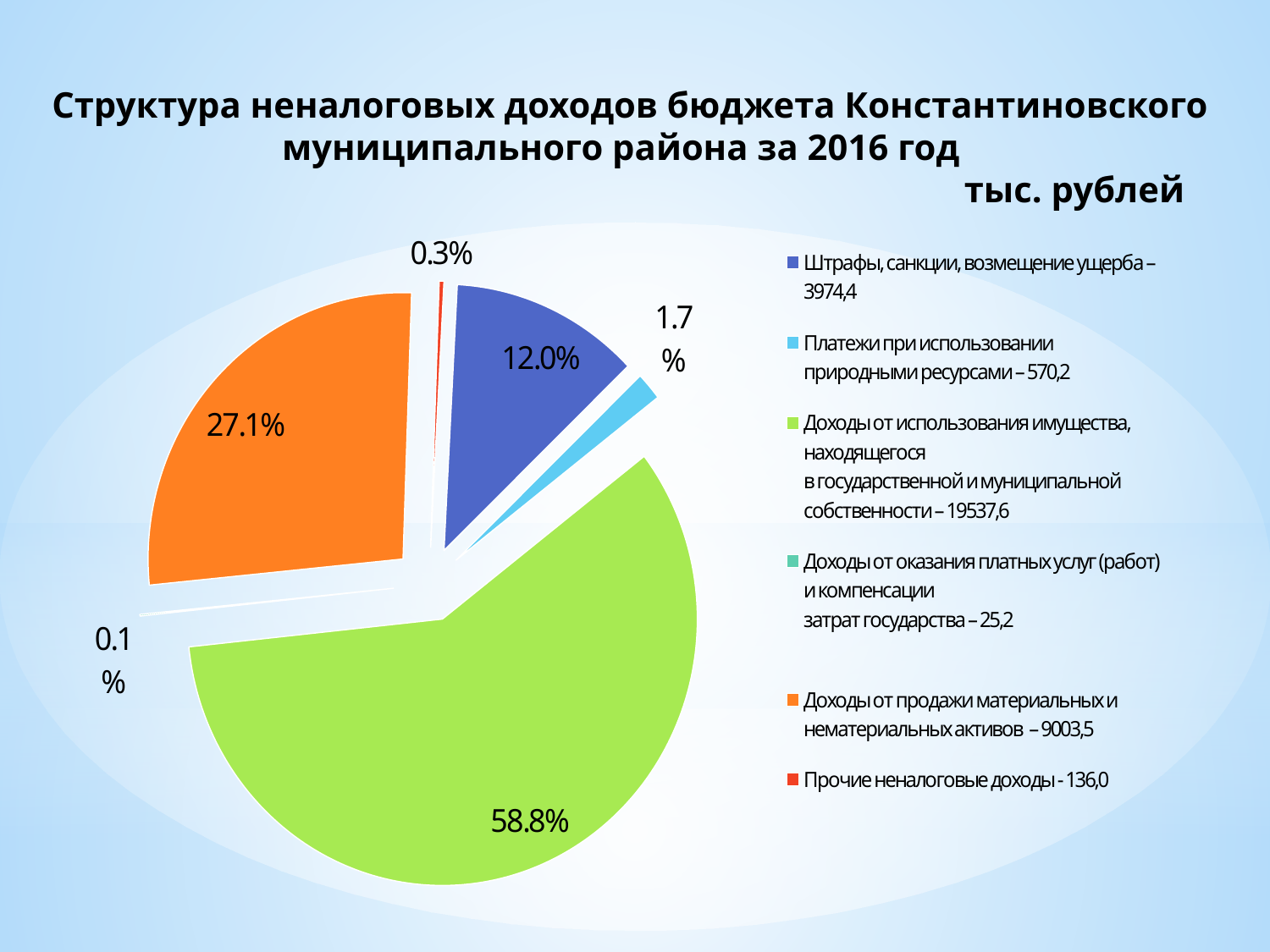
Which is larger: the 'Прочие неналоговые доходы' slice or the 'Платежи при использовании природными ресурсами' slice? Платежи при использовании природными ресурсами What value in thousand rubles does the legend give for 'Прочие неналоговые доходы'? 136,0 What type of chart is shown on the slide? pie chart What share of the pie is 'Доходы от продажи материальных и нематериальных активов'? 27.1% What share of the pie is 'Штрафы, санкции, возмещение ущерба'? 12.0% Which category has the smallest slice of the pie? Доходы от оказания платных услуг (работ) и компенсации затрат государства What share of the pie is 'Платежи при использовании природными ресурсами'? 1.7% Which category has the largest slice of the pie? Доходы от использования имущества, находящегося в государственной и муниципальной собственности How many slices does the pie chart have? 6 What is the difference in percentage points between the 'Доходы от продажи материальных и нематериальных активов' slice and the 'Штрафы, санкции, возмещение ущерба' slice? 15.1 How many entries does the legend list? 6